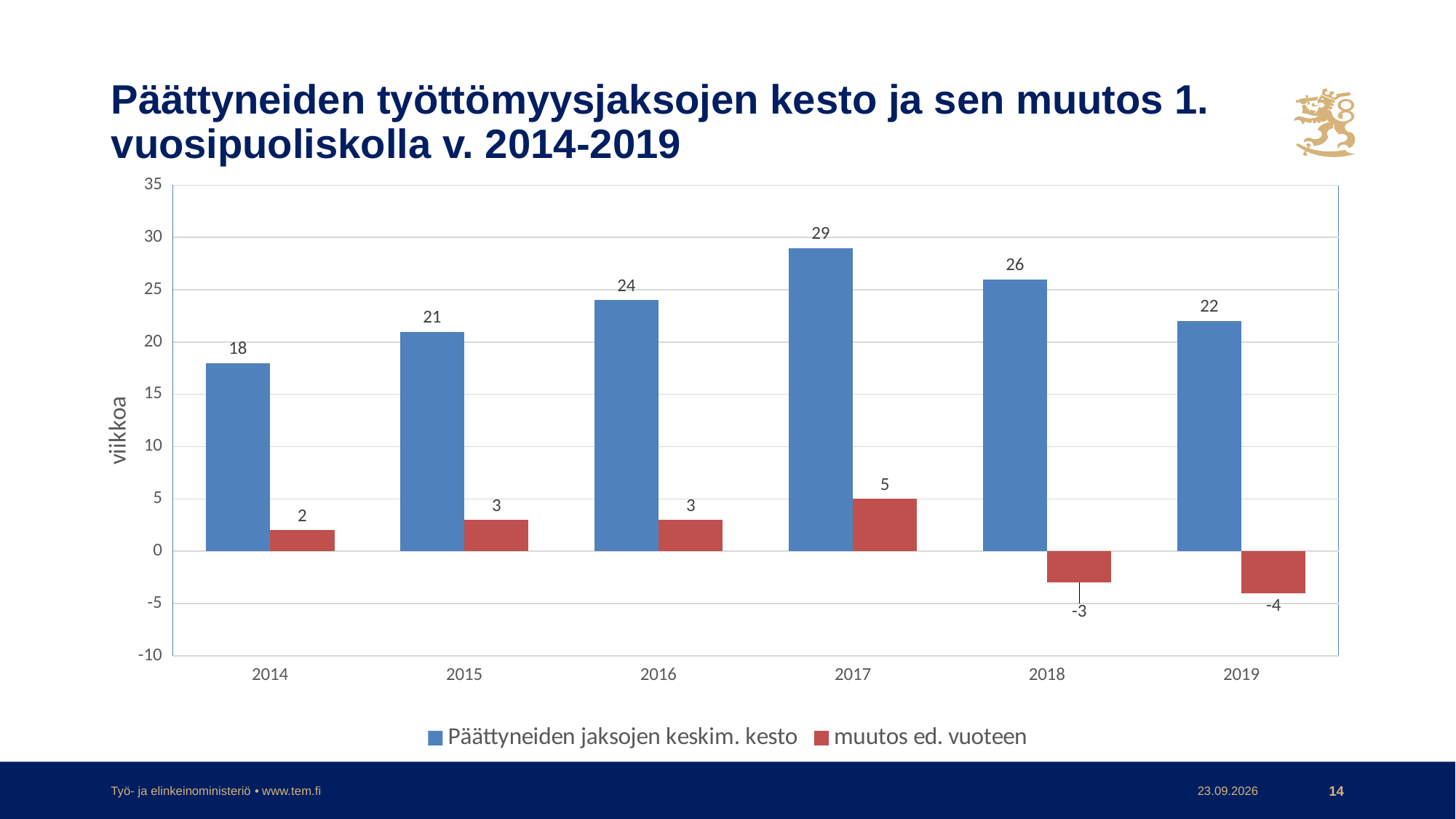
Is the value for 'Päättyneiden jaksojen keskim. kesto' in 2015 greater or less than 25? less How many series does the legend list? 2 What is the difference between the 'Päättyneiden jaksojen keskim. kesto' values for 2017 and 2019? 7 Which is larger: the 'Päättyneiden jaksojen keskim. kesto' value for 2016 or for 2018? 2018 How many years are shown on the x axis? 6 Which year has the lowest value for 'muutos ed. vuoteen'? 2019 What is the label on the vertical axis? viikkoa What kind of chart is shown on the slide? bar chart Which year has the highest value for 'Päättyneiden jaksojen keskim. kesto'? 2017 What is the value of 'Päättyneiden jaksojen keskim. kesto' for 2017? 29 What is the value of 'Päättyneiden jaksojen keskim. kesto' for 2014? 18 What is the value of 'muutos ed. vuoteen' for 2019? -4